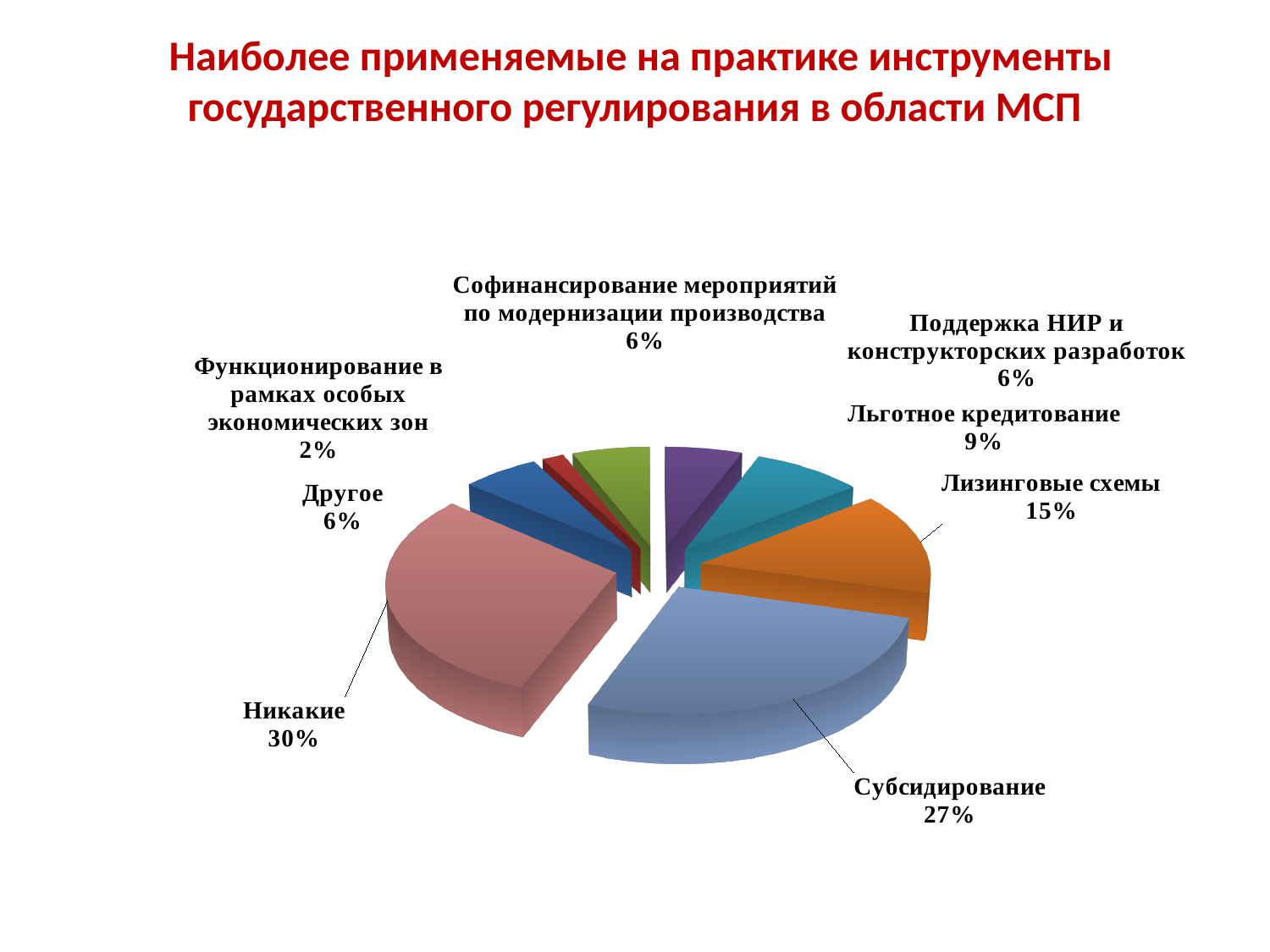
Which category has the largest share of the pie? Никакие What share of the pie does "Никакие" have? 30% What is the value shown for "Льготное кредитование"? 9% What is the value shown for "Функционирование в рамках особых экономических зон"? 2% What is the difference between the shares of "Никакие" and "Субсидирование"? 3% What is the value shown for "Поддержка НИР и конструкторских разработок"? 6% Which is larger, the share for "Лизинговые схемы" or the share for "Льготное кредитование"? Лизинговые схемы Which category has the smallest share of the pie? Функционирование в рамках особых экономических зон What is the value shown for "Субсидирование"? 27% What is the value shown for "Лизинговые схемы"? 15% What kind of chart is shown on the slide? pie chart How many slices does the pie chart have? 8